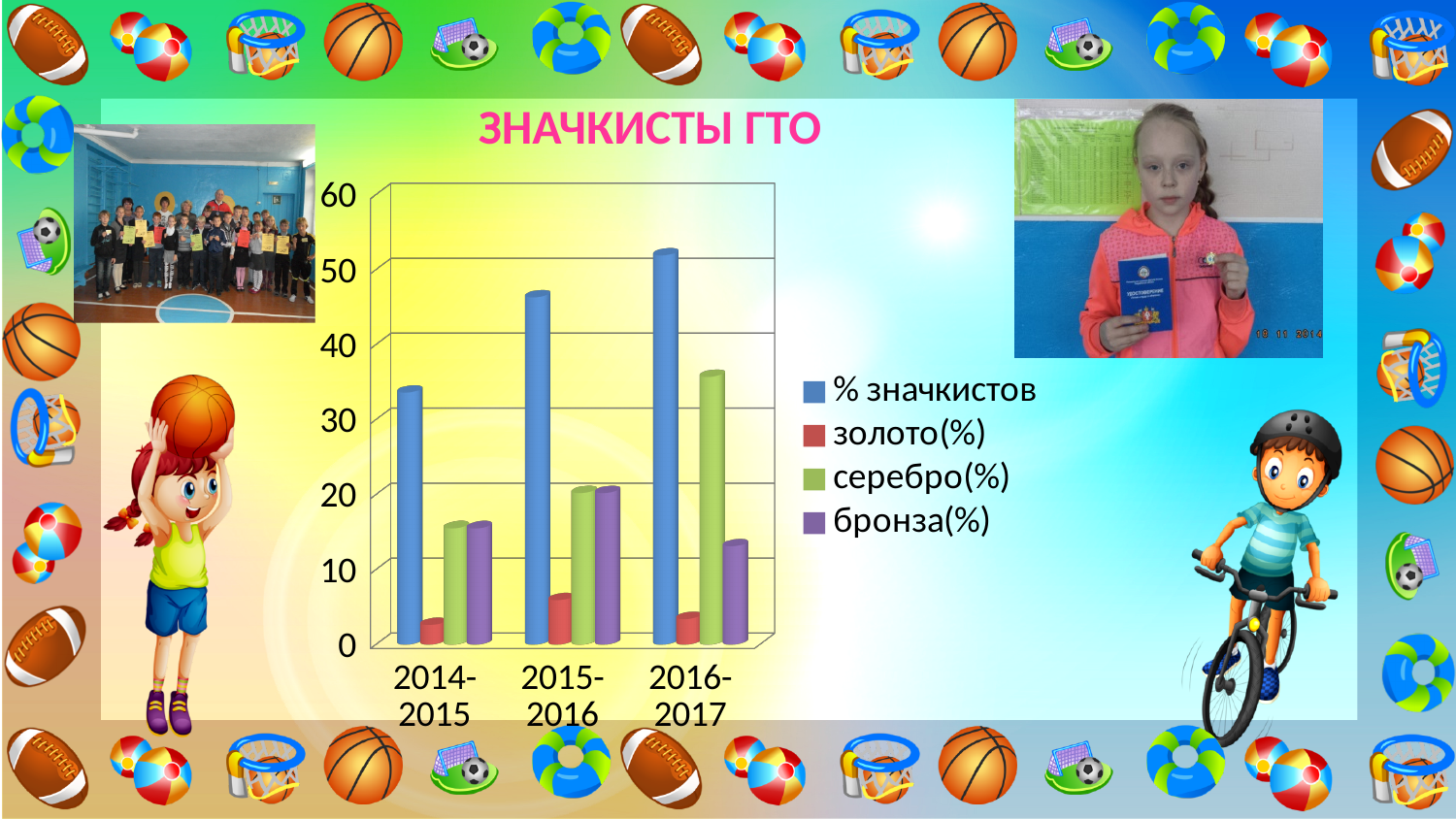
Is the value for серебро(%) in 2016-2017 greater or less than 30? greater In which school year is серебро(%) highest? 2016-2017 Is the value for % значкистов in 2015-2016 greater or less than 40? greater How many series does the chart legend list? 4 What is the title of the chart on the slide? ЗНАЧКИСТЫ ГТО In which school year is % значкистов lowest? 2014-2015 Does the value for % значкистов rise or fall from 2014-2015 to 2016-2017? rise In 2016-2017, which is larger: серебро(%) or бронза(%)? серебро(%) In which school year is % значкистов highest? 2016-2017 Is the value for золото(%) in 2015-2016 greater or less than 10? less How many categories (school years) are shown on the x axis of the chart? 3 What kind of chart is shown on the slide? bar chart